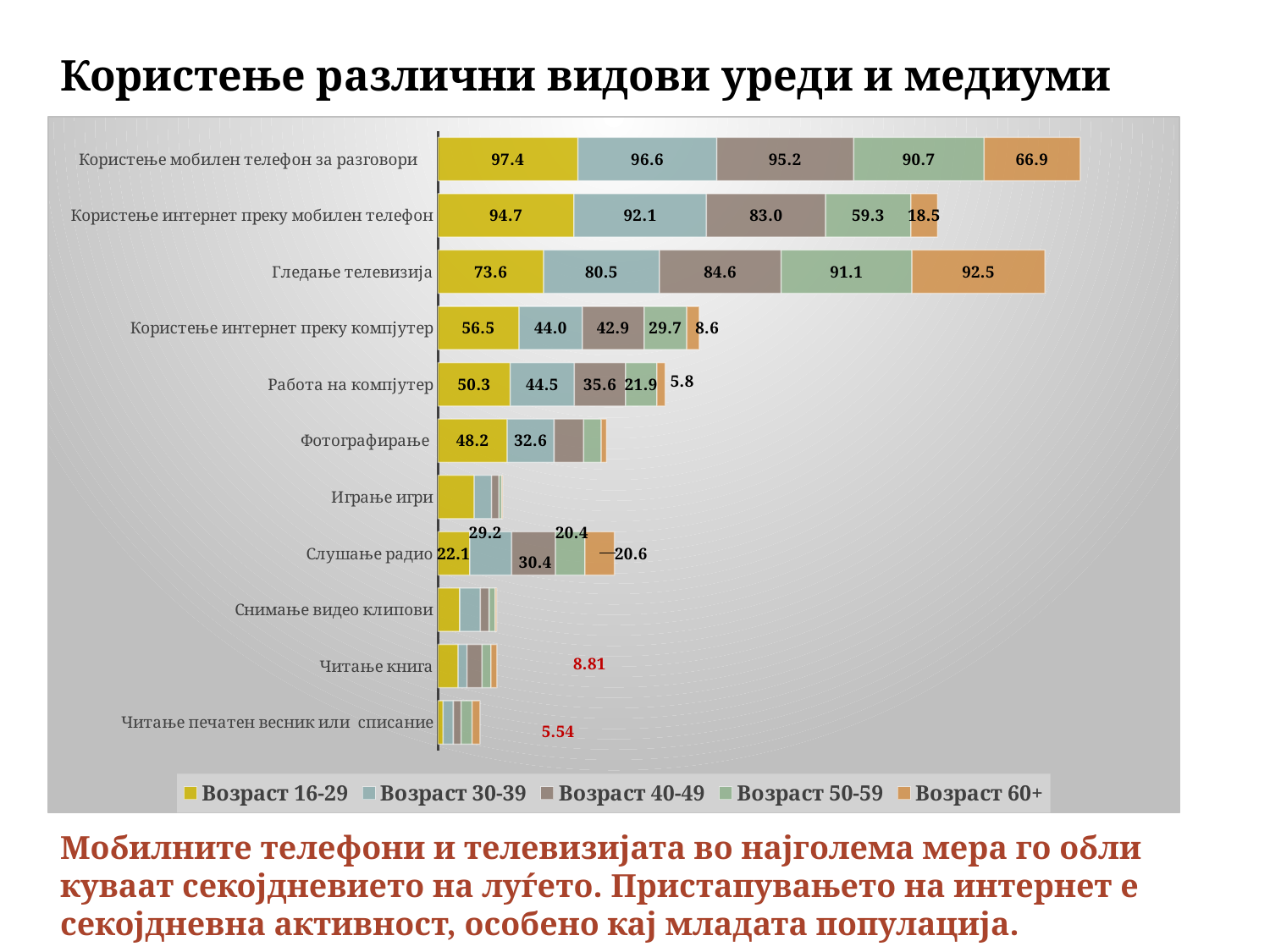
For Возраст 16-29, which is larger: Гледање телевизија or Користење интернет преку компјутер? Гледање телевизија What is the value for Возраст 60+ in the Гледање телевизија bar? 92.5 How many categories (activities) are shown on the chart? 11 Within the Користење интернет преку компјутер bar, which age group has the lowest value? Возраст 60+ What is the total of the stacked Користење мобилен телефон за разговори bar? 446.8 What is the value for Возраст 16-29 in the Користење мобилен телефон за разговори bar? 97.4 How many series does the legend list? 5 What kind of chart is shown on the slide? Stacked bar chart What is the value for Возраст 50-59 in the Користење интернет преку мобилен телефон bar? 59.3 Within the Гледање телевизија bar, which age group has the highest value? Возраст 60+ What is the value for Возраст 60+ in the Работа на компјутер bar? 5.8 In the Користење мобилен телефон за разговори bar, what is the difference between the Возраст 16-29 value and the Возраст 60+ value? 30.5